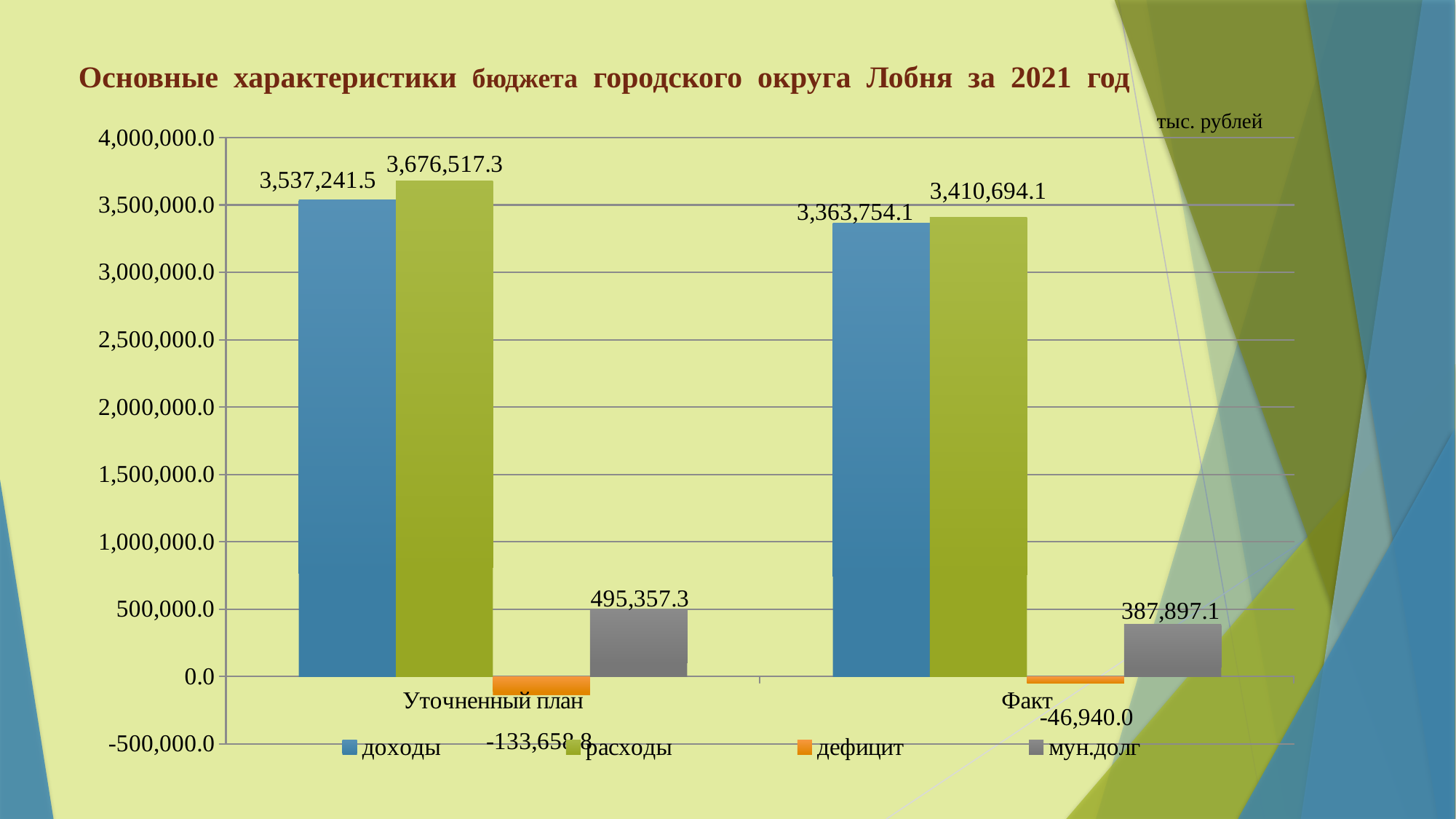
Which series has the highest value in the Уточненный план category? расходы What is the difference between расходы and доходы for Факт? 46,940.0 How many categories are shown on the x axis? 2 How many series does the legend list? 4 What is the value of мун.долг for Уточненный план? 495,357.3 What kind of chart is shown on the slide? bar chart What is the value of доходы for Факт? 3,363,754.1 What is the value of дефицит for Факт? -46,940.0 What is the value of доходы for Уточненный план? 3,537,241.5 What unit is indicated in the top right corner of the chart? тыс. рублей Which is larger: мун.долг for Уточненный план or мун.долг for Факт? Уточненный план What is the value of расходы for Факт? 3,410,694.1